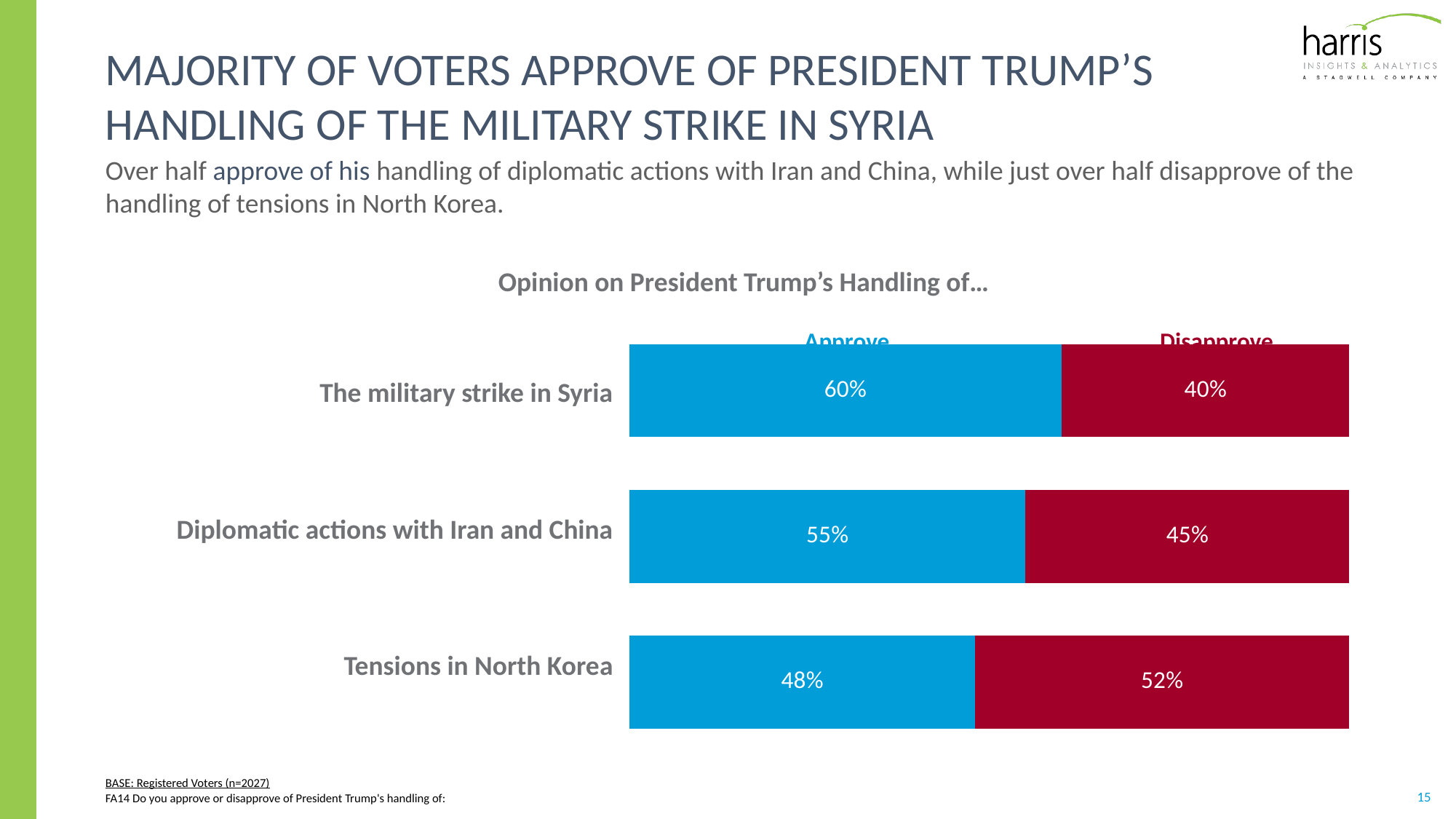
What is the title of the chart? Opinion on President Trump's Handling of... Which item has the lowest Approve percentage? Tensions in North Korea How many series does the chart show? 2 What type of chart is shown on the slide? Stacked bar chart For tensions in North Korea, is the Approve or Disapprove percentage larger? Disapprove Which item has the highest Approve percentage? The military strike in Syria What is the Disapprove value for the military strike in Syria? 40% What is the Approve value for diplomatic actions with Iran and China? 55% What percentage of voters approve of President Trump's handling of the military strike in Syria? 60% How many items are shown in the chart? 3 What is the difference between the Approve and Disapprove percentages for the military strike in Syria? 20 percentage points What percentage of voters disapprove of President Trump's handling of tensions in North Korea? 52%